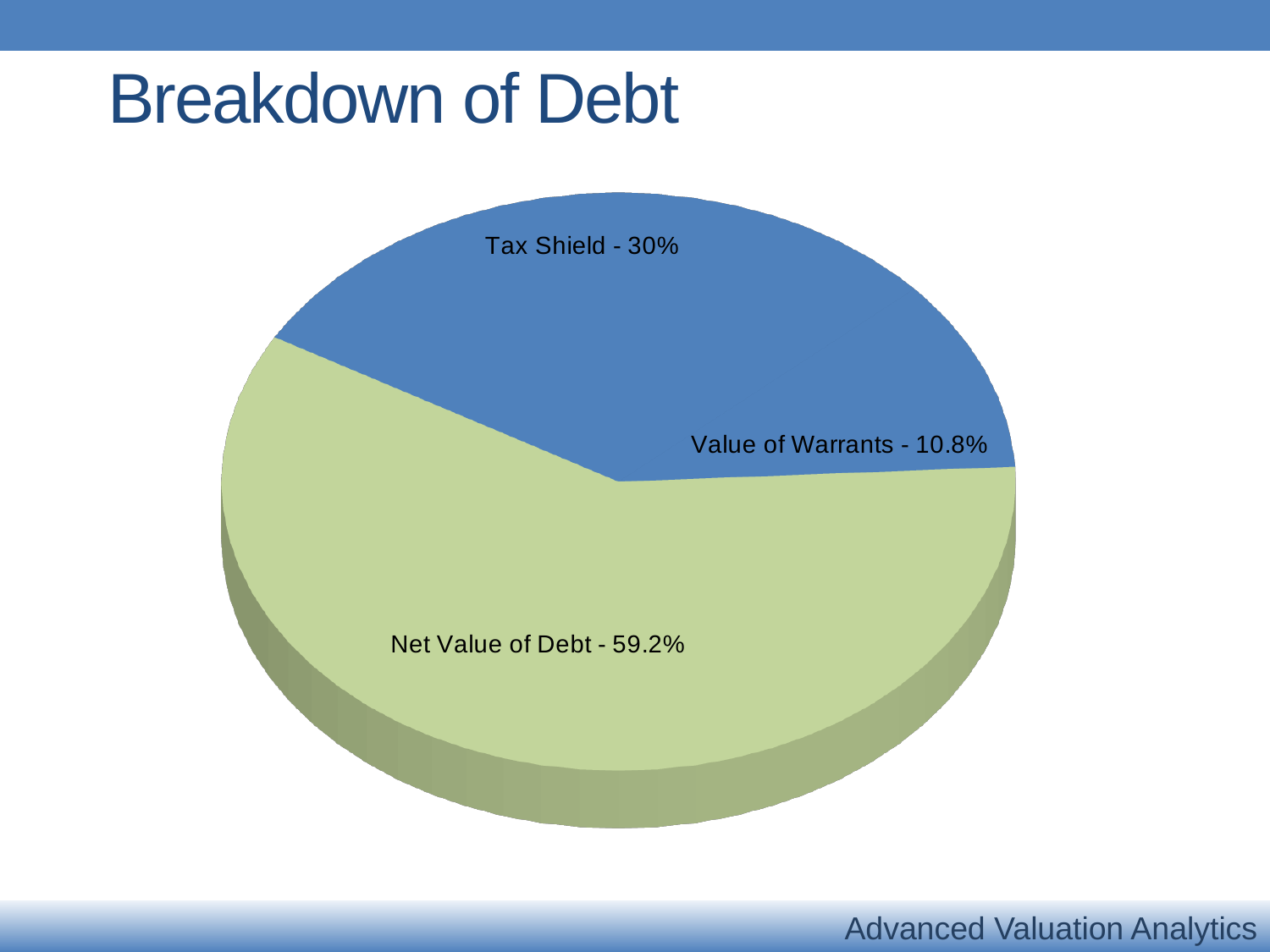
Which slice of the pie is the smallest? Value of Warrants What share of the pie does Value of Warrants represent? 10.8% Which slice of the pie is the largest? Net Value of Debt What share of the pie does Tax Shield represent? 30% What is the difference in percentage points between Net Value of Debt and Tax Shield? 29.2 What share of the pie does Net Value of Debt represent? 59.2% What is the difference in percentage points between Tax Shield and Value of Warrants? 19.2 Which is larger, Net Value of Debt or Tax Shield? Net Value of Debt What kind of chart is shown on the slide? Pie chart Which is larger, Tax Shield or Value of Warrants? Tax Shield How many slices does the pie chart have? 3 What is the title of the chart on the slide? Breakdown of Debt